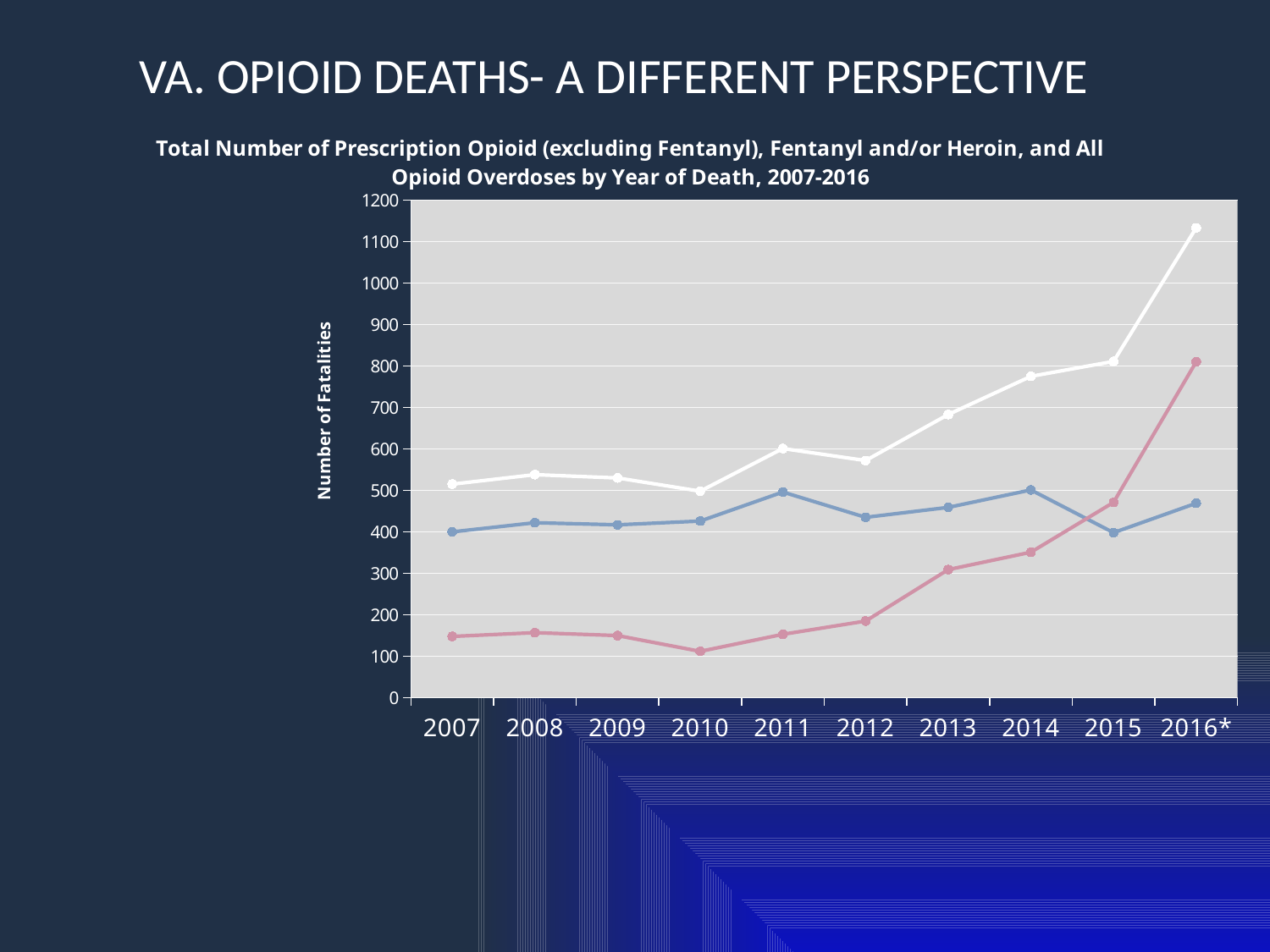
Is the value of the white line in 2014 greater or less than 700? greater Is the value of the pink line in 2010 greater or less than 200? less In which year does the white line reach its highest value? 2016* What kind of chart is shown on the slide? line chart Does the white line generally rise or fall from 2007 to 2016*? rise How many years are shown along the x axis of the chart? 10 Is the value of the white line in 2016* greater or less than 1100? greater What is the title of the y axis? Number of Fatalities In which year does the pink line reach its lowest value? 2010 In 2016*, which line has the higher value, the pink line or the blue line? pink line How many lines are plotted on the chart? 3